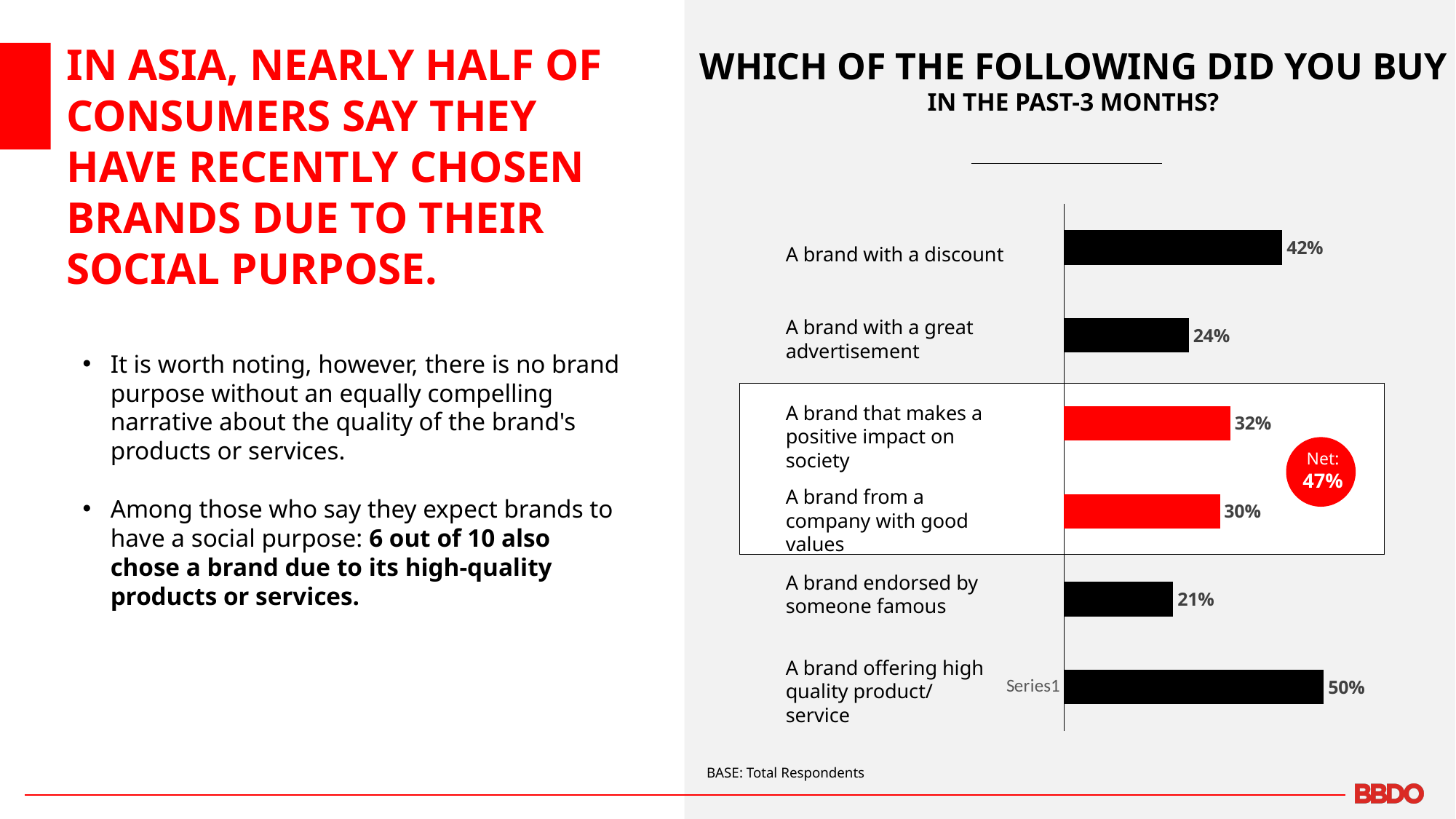
What is the difference between the values for 'A brand with a discount' and 'A brand with a great advertisement'? 18% What kind of chart is shown on the slide? Bar chart Which category has the highest value in the chart? A brand offering high quality product/ service What percentage bought a brand that makes a positive impact on society? 32% How many categories are shown in the chart? 6 What colour are the bars for the two highlighted social-purpose categories? Red What is the value for 'A brand offering high quality product/ service'? 50% Which is larger: the value for 'A brand that makes a positive impact on society' or 'A brand from a company with good values'? A brand that makes a positive impact on society What is the net value shown in the red circle for the two highlighted categories? 47% Which category has the lowest value in the chart? A brand endorsed by someone famous What is the value for 'A brand endorsed by someone famous'? 21% What percentage of respondents bought a brand with a discount in the past 3 months? 42%